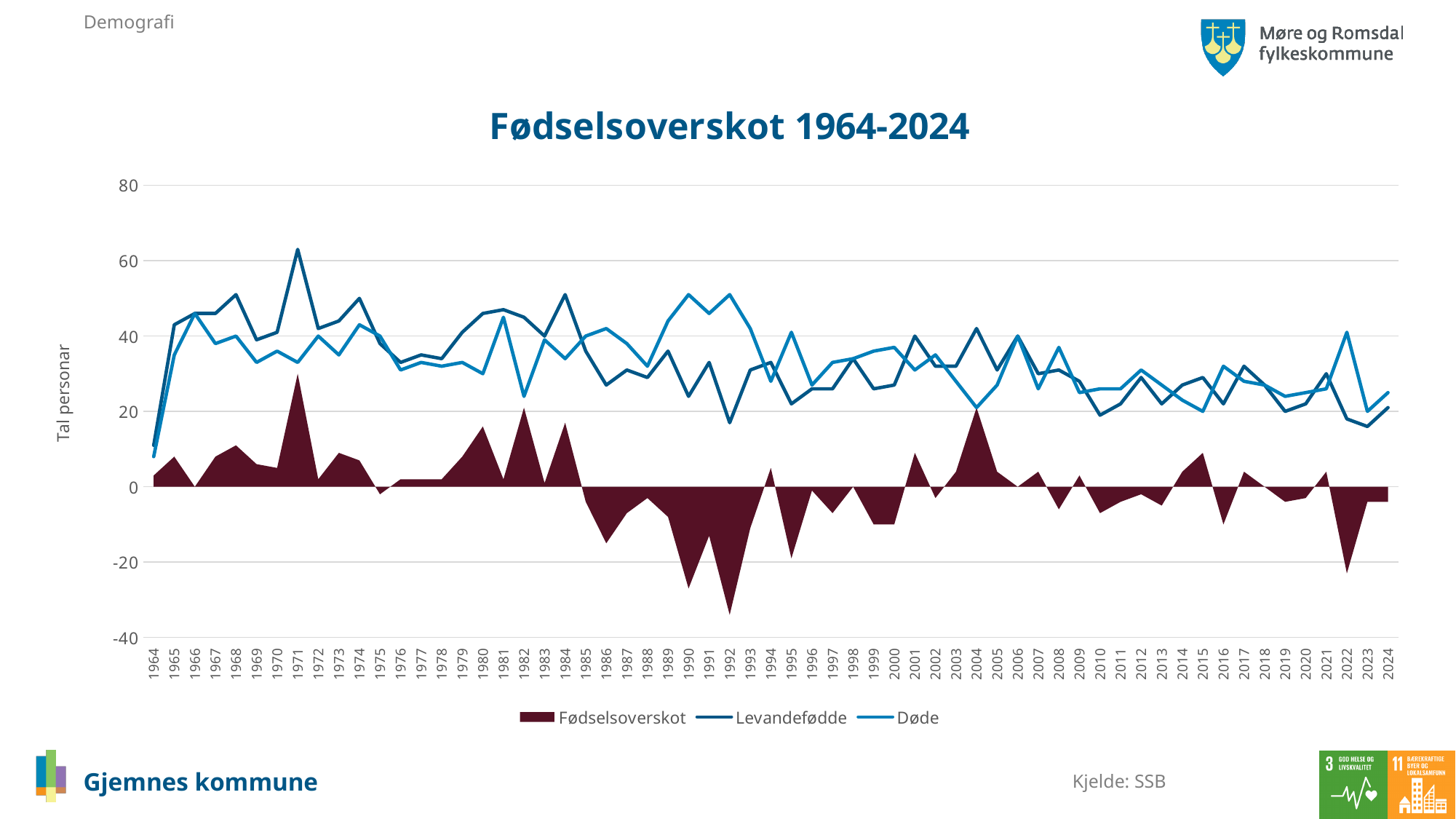
Does the Levandefødde series generally rise or fall from 1971 to 2024? fall In which year does the Levandefødde series reach its highest value? 1971 What are the three series named in the legend? Fødselsoverskot, Levandefødde, Døde Is the value for Fødselsoverskot in 1992 greater or less than -20? less How many years are plotted along the x axis? 61 In which year does the Fødselsoverskot series reach its lowest value? 1992 In 1990, which is larger: Døde or Levandefødde? Døde What kind of chart is used to plot the Levandefødde and Døde series? line chart In which year is the Døde series at its lowest? 1964 Is the value for Levandefødde in 1971 greater or less than 40? greater How many series does the legend list? 3 What is the title of the chart? Fødselsoverskot 1964-2024